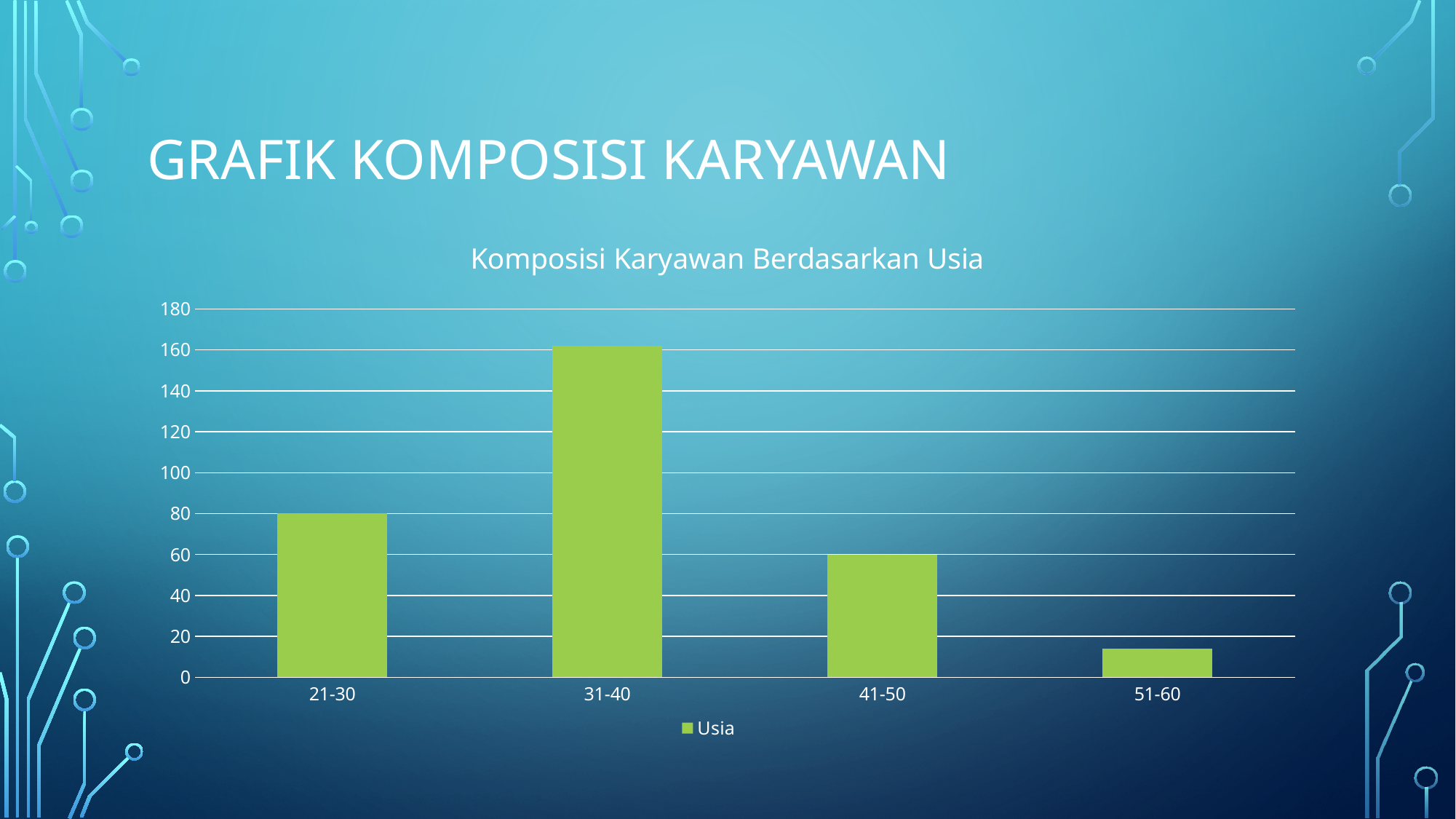
What is the value for the 21-30 age group? 80 What is the value for the 41-50 age group? 60 How many series does the legend list? 1 What kind of chart is shown on the slide? bar chart What is the difference between the values for 21-30 and 41-50? 20 Which age group has the lowest value? 51-60 What is the name of the series in the legend? Usia Is the value for 31-40 greater or less than 140? greater Which age group has the highest value? 31-40 How many age categories are shown on the x axis? 4 What is the title of the chart? Komposisi Karyawan Berdasarkan Usia Is the value for 51-60 greater or less than 20? less